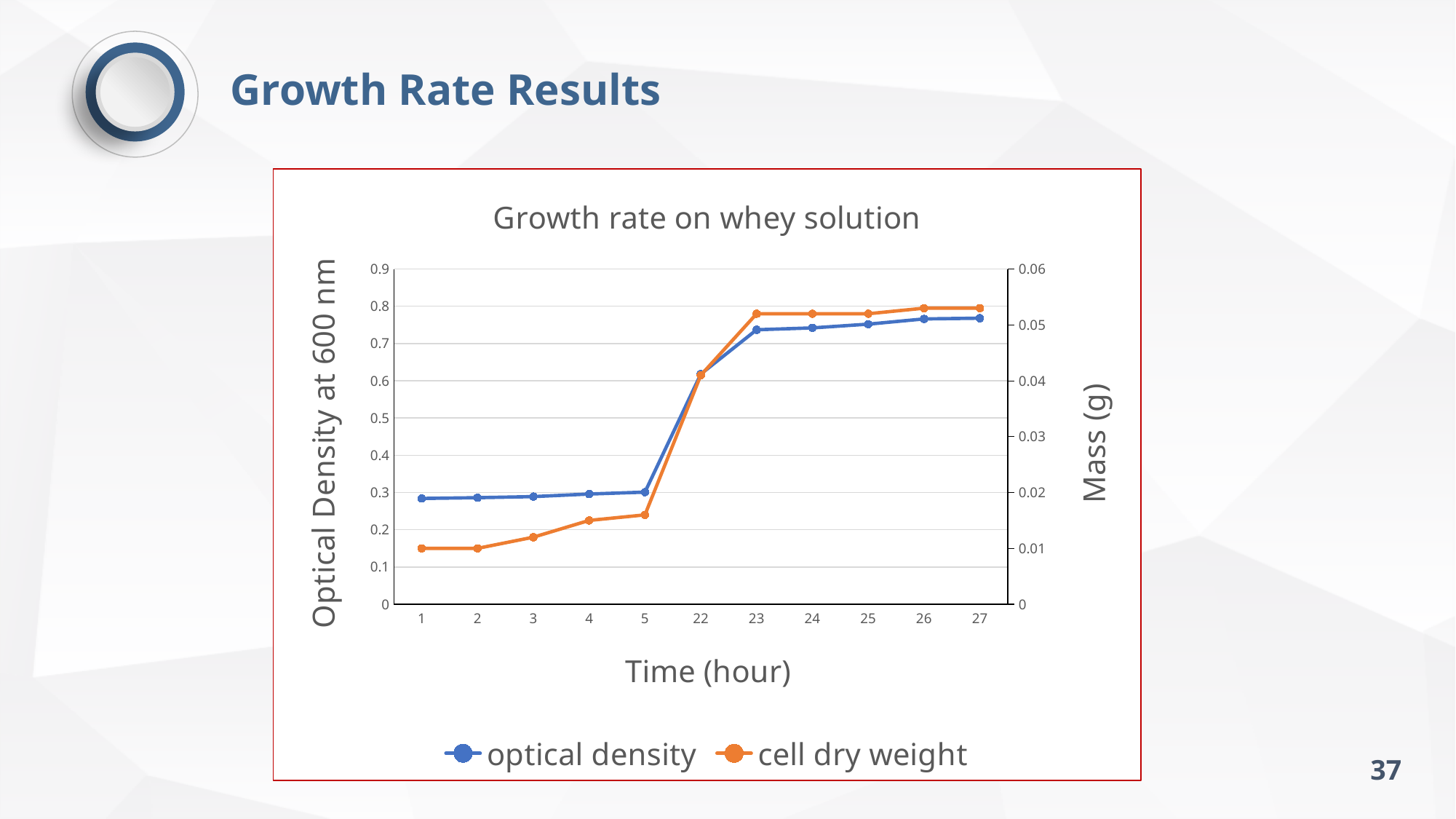
Is the optical density value at hour 23 greater or less than 0.7? greater Do the optical density values generally rise or fall as time increases along the x axis? rise Is the optical density value at hour 22 greater or less than 0.5? greater How many time points are plotted along the x axis? 11 What kind of chart is shown on the slide? line chart Is the optical density value at hour 5 greater or less than 0.5? less Which is larger for optical density: the value at hour 5 or the value at hour 22? hour 22 How many series does the legend list? 2 What is the label of the right-hand vertical axis? Mass (g) What is the title of the chart? Growth rate on whey solution